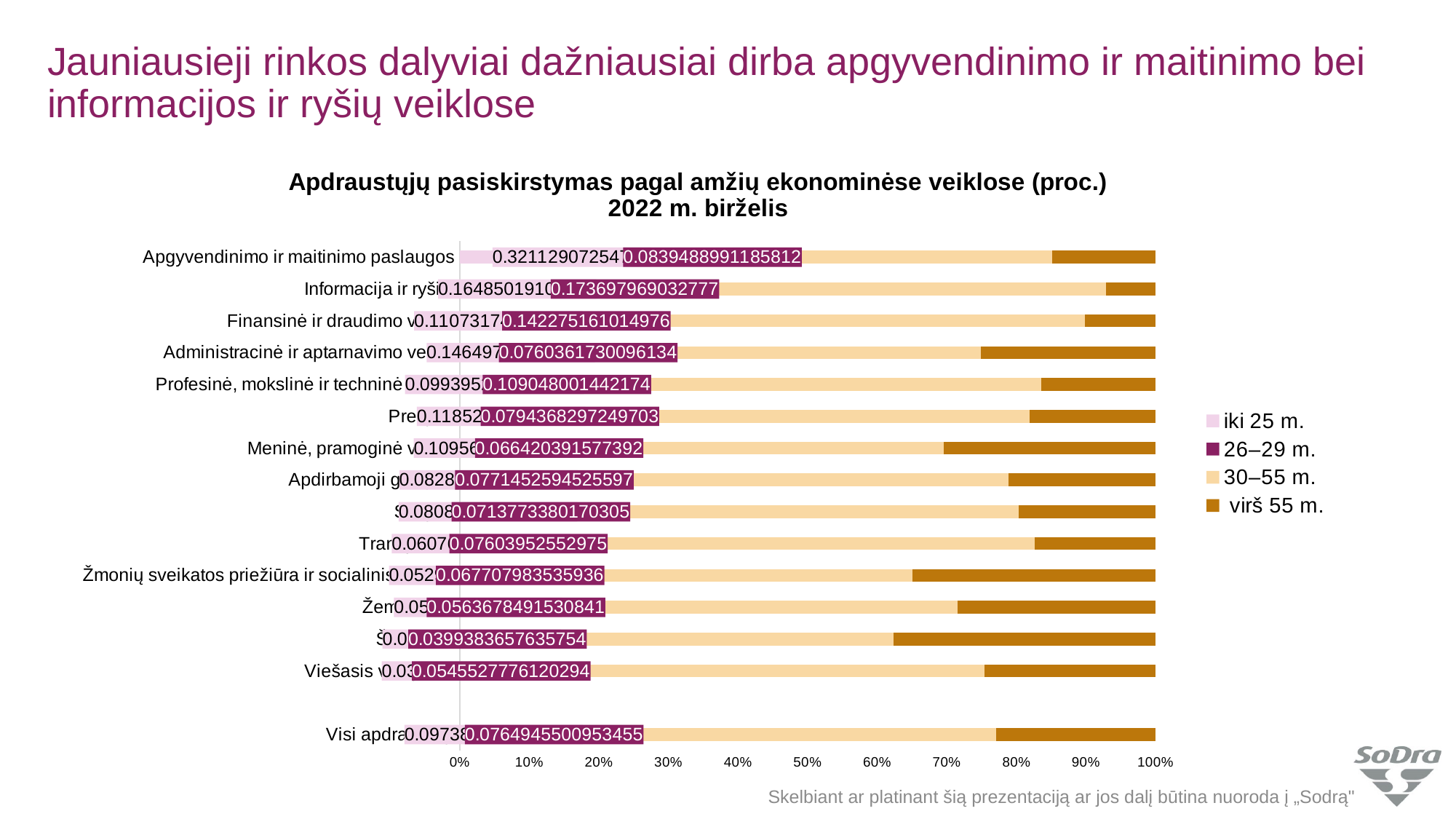
What is the 26–29 m. value for the bottom bar labelled 'Visi apdra…'? 0.0764945500953455 How many series does the legend list? 4 What are the legend entries of the chart? iki 25 m., 26–29 m., 30–55 m., virš 55 m. Which has the larger 26–29 m. value: Finansinė ir draudimo veikla or Administracinė ir aptarnavimo veikla? Finansinė ir draudimo veikla Is the virš 55 m. share for Žmonių sveikatos priežiūra ir socialinis darbas greater or less than 30%? greater What kind of chart is shown on the slide? Stacked bar chart What is the 26–29 m. value for Finansinė ir draudimo veikla? 0.142275161014976 What is the 26–29 m. value for Profesinė, mokslinė ir techninė veikla? 0.109048001442174 What is the 26–29 m. value for Žmonių sveikatos priežiūra ir socialinis darbas? 0.067707983535936 What is the 26–29 m. value for Informacija ir ryšiai? 0.173697969032777 What is the 26–29 m. value for Apgyvendinimo ir maitinimo paslaugos? 0.0839488991185812 Which category has the highest 26–29 m. value? Informacija ir ryšiai